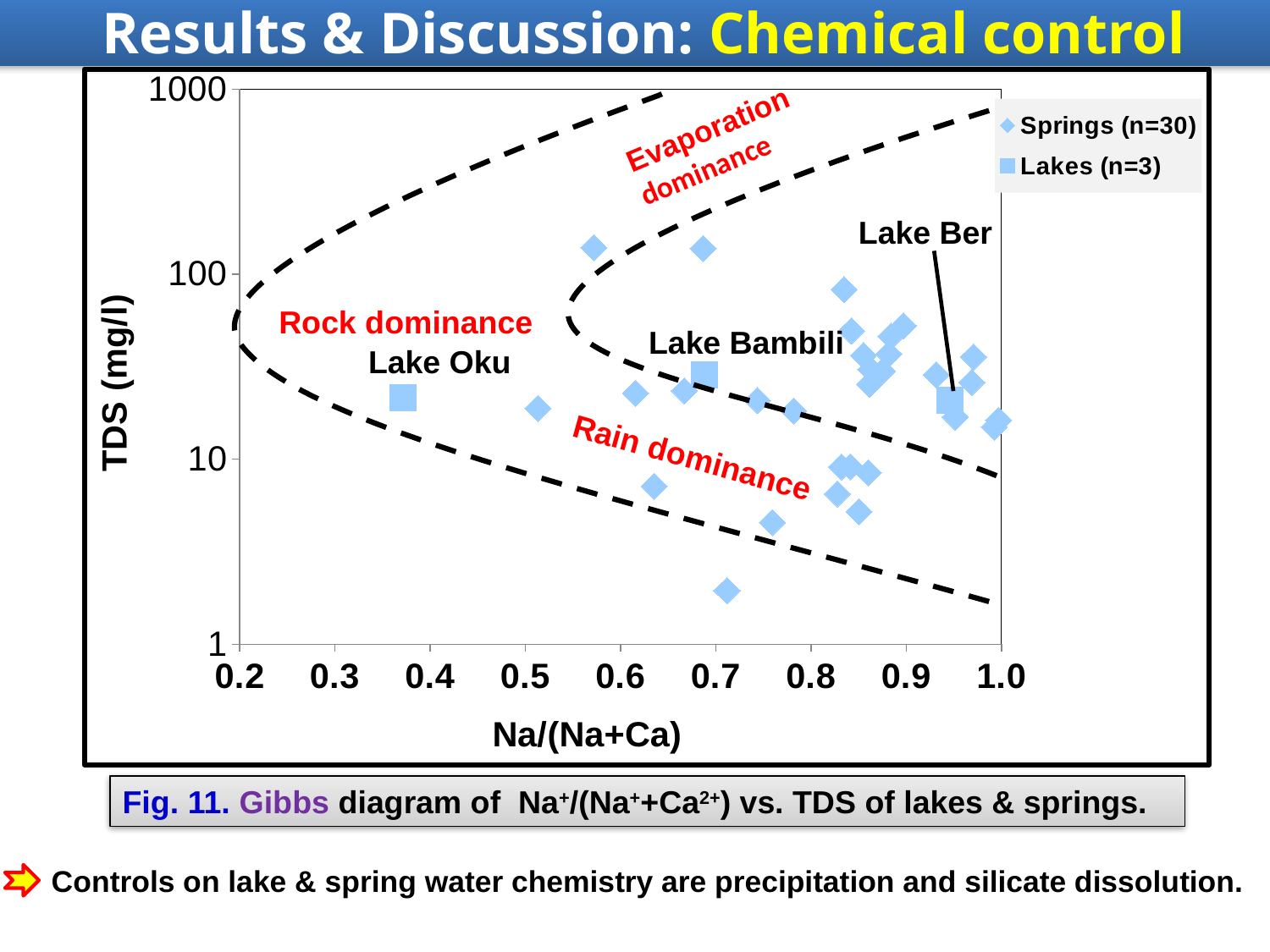
Is the TDS value for Lake Oku greater or less than 100? less According to the legend, how many lakes are plotted? 3 Is the Na/(Na+Ca) value for Lake Ber greater or less than 0.9? greater Is the TDS value for Lake Bambili greater or less than 10? greater What is the label of the y axis? TDS (mg/l) According to the legend, how many springs are plotted? 30 Which of the labelled lakes has the highest Na/(Na+Ca) value? Lake Ber What is the label of the x axis? Na/(Na+Ca) What kind of chart is shown on the slide? Scatter plot Which has the larger Na/(Na+Ca) value, Lake Oku or Lake Bambili? Lake Bambili How many series does the legend list? 2